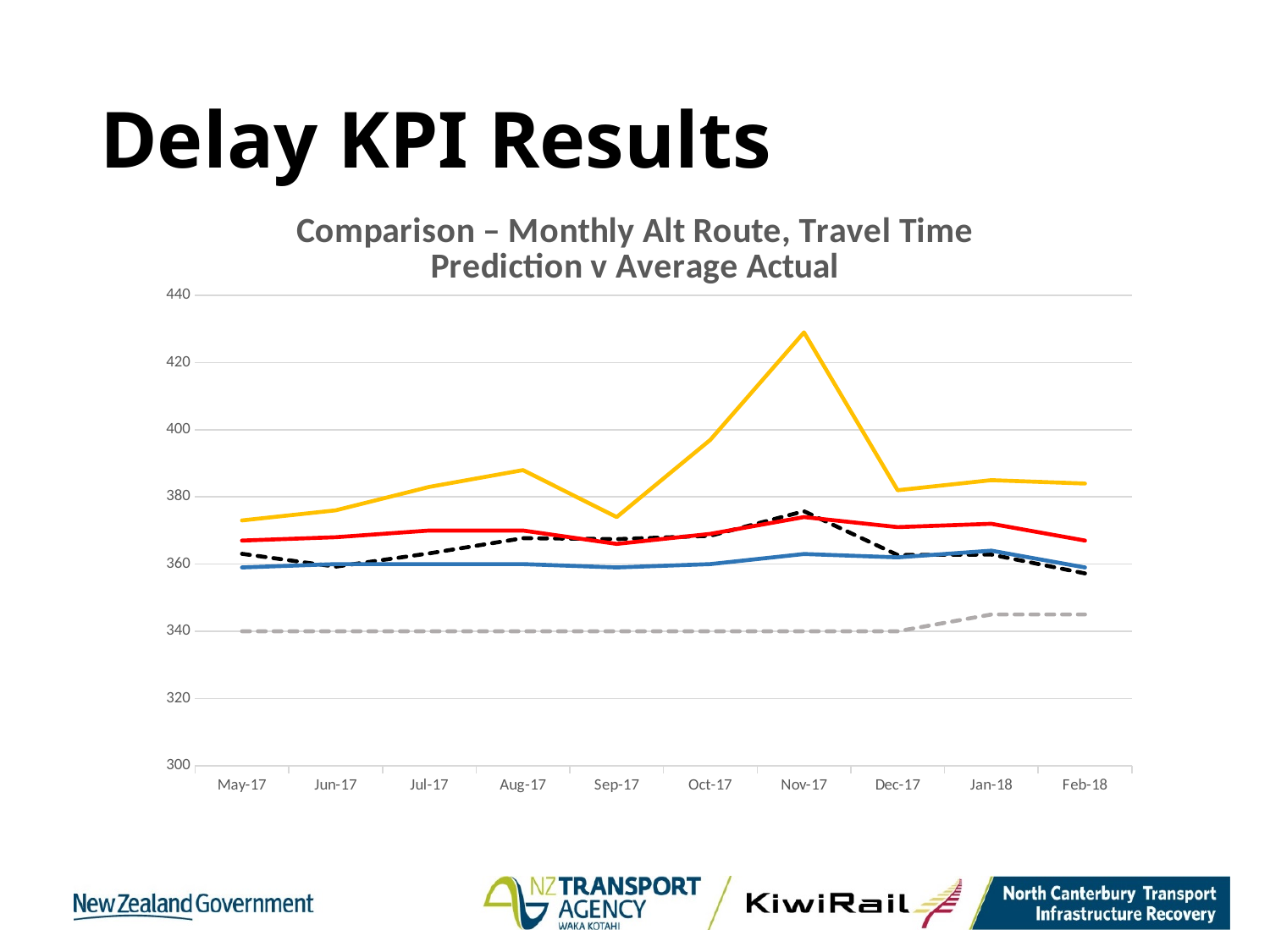
Is the value of the grey dashed line at May-17 greater or less than 360? less What are the lowest and highest values shown on the y axis? 300 and 440 How many months are plotted along the x axis? 10 Is the value of the blue line at Nov-17 greater or less than 380? less What kind of chart is shown on the slide? Line chart Is the value of the red line at Jan-18 greater or less than 360? greater In which month does the yellow line reach its highest value? Nov-17 At Aug-17, which is higher: the red line or the blue line? red line At Nov-17, which is higher: the yellow line or the blue line? yellow line Does the grey dashed line rise or fall between Dec-17 and Feb-18? rises What is the title of the chart? Comparison – Monthly Alt Route, Travel Time Prediction v Average Actual